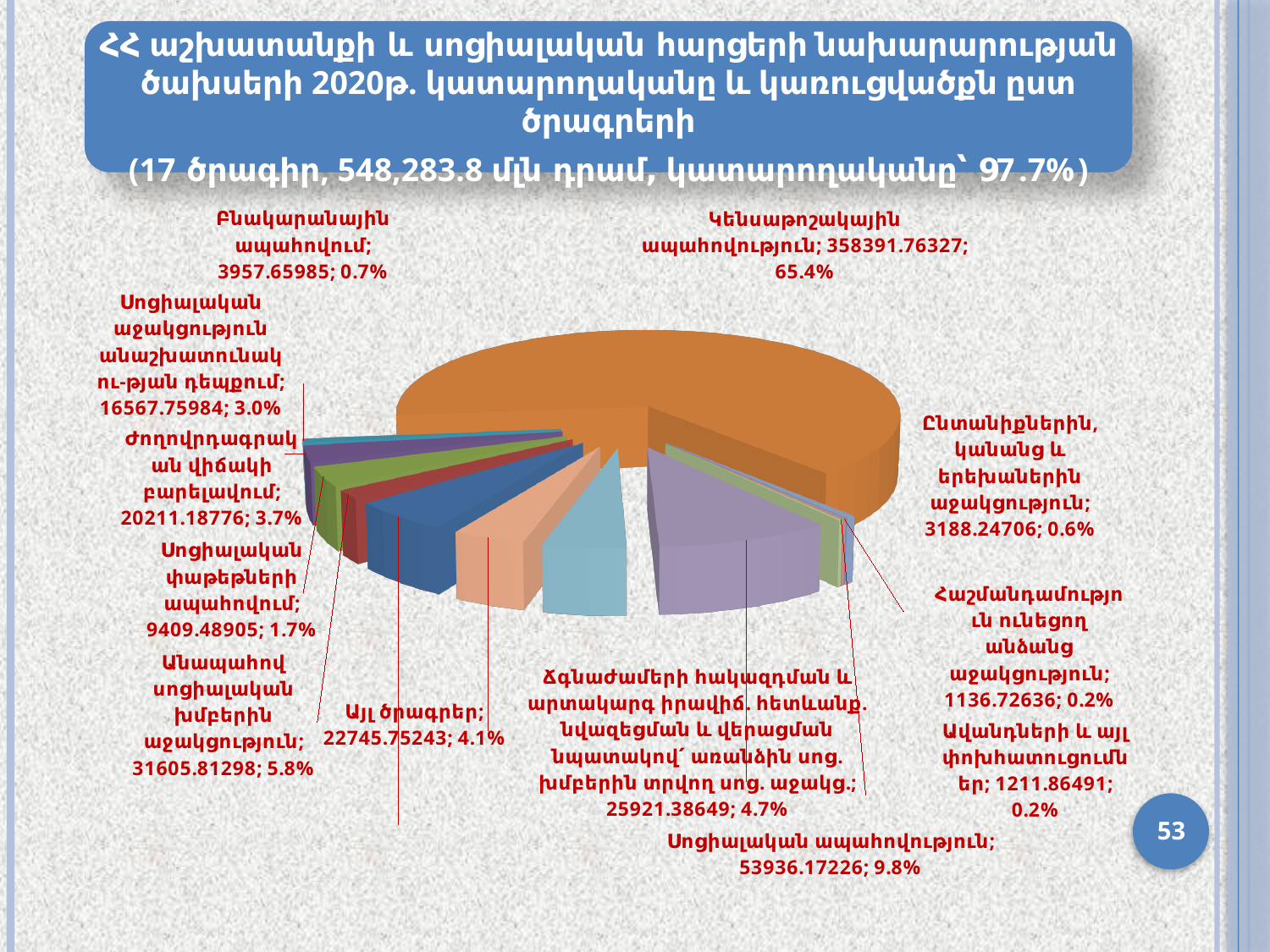
According to the chart title, how many programs (ծրագիր) are covered and what is the total amount? 17 ծրագիր, 548,283.8 մլն դրամ How many categories are labelled on the pie chart? 12 What is the difference between the values for Սոցիալական ապահովություն and Անապահով սոցիալական խմբերին աջակցություն? 22330.35928 What percentage is shown for Այլ ծրագրեր? 4.1% Which category has the largest slice of the pie? Կենսաթոշակային ապահովություն What is the difference in percentage share between Կենսաթոշակային ապահովություն and Սոցիալական ապահովություն? 55.6% What value is shown for Սոցիալական ապահովություն? 53936.17226 What value is shown for Կենսաթոշակային ապահովություն? 358391.76327 What share of the pie does Կենսաթոշակային ապահովություն represent? 65.4% Which is larger: Ժողովրդագրական վիճակի բարելավում or Սոցիալական փաթեթների ապահովում? Ժողովրդագրական վիճակի բարելավում What kind of chart is shown on the slide? pie chart What value is shown for Անապահով սոցիալական խմբերին աջակցություն? 31605.81298